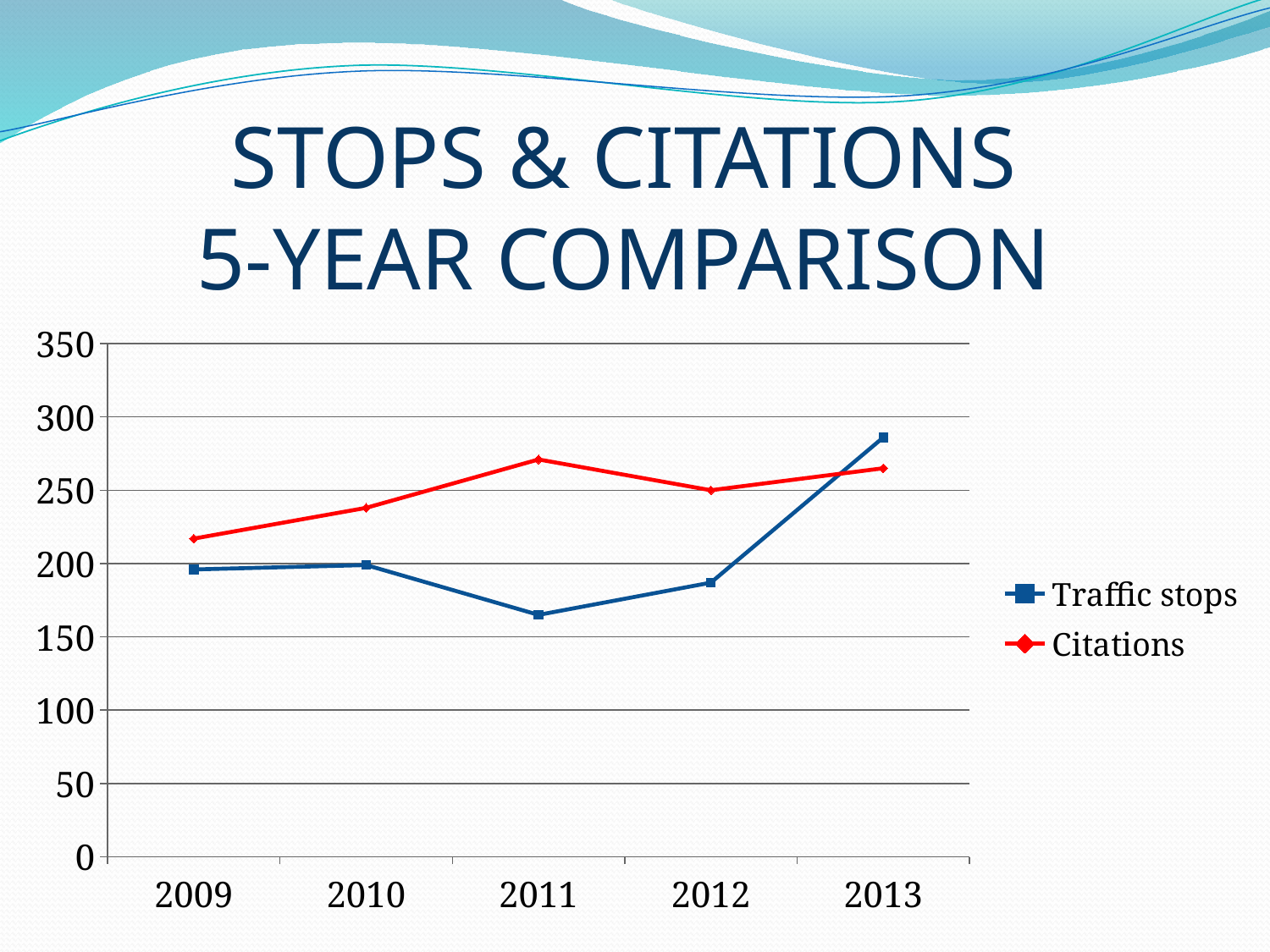
Do the Citations values rise or fall from 2009 to 2011? Rise How many years are plotted along the x axis? 5 In which year is the Citations value lowest? 2009 Is the Traffic stops value for 2011 greater or less than 200? less In which year is the Traffic stops value lowest? 2011 In which year is the Citations value highest? 2011 In which year is the Traffic stops value highest? 2013 What kind of chart is shown on the slide? Line chart Is the Citations value for 2011 greater or less than 250? greater Which colour is used for the Citations line? Red How many series does the legend list? 2 In 2011, which series has the larger value, Traffic stops or Citations? Citations